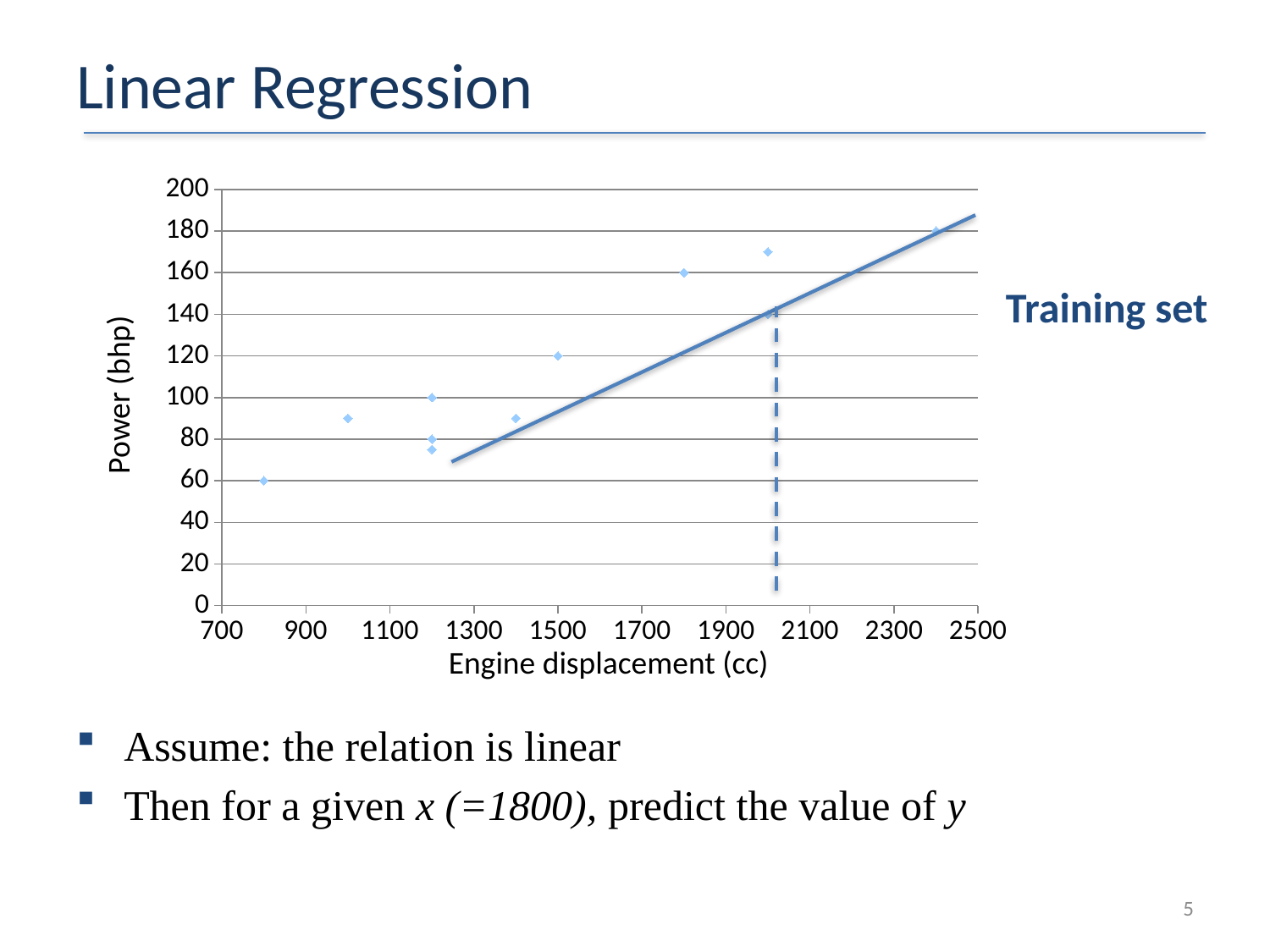
Is the power value for the data point at 800 cc greater or less than 80? less What is the label of the vertical axis of the chart? Power (bhp) What is the label of the horizontal axis of the chart? Engine displacement (cc) Which data point has the lowest power value in the chart? the one at 800 cc Is the power value for the data point at 1500 cc greater or less than 100? greater What kind of chart is shown on the slide? scatter chart Do the plotted power values generally rise or fall as engine displacement increases? rise Which data point has the highest power value: the one at 2000 cc or the one at 2400 cc? the one at 2400 cc Is the power value for the data point at 1400 cc greater or less than 100? less Which data point has a higher power value: the one at 800 cc or the one at 1000 cc? the one at 1000 cc